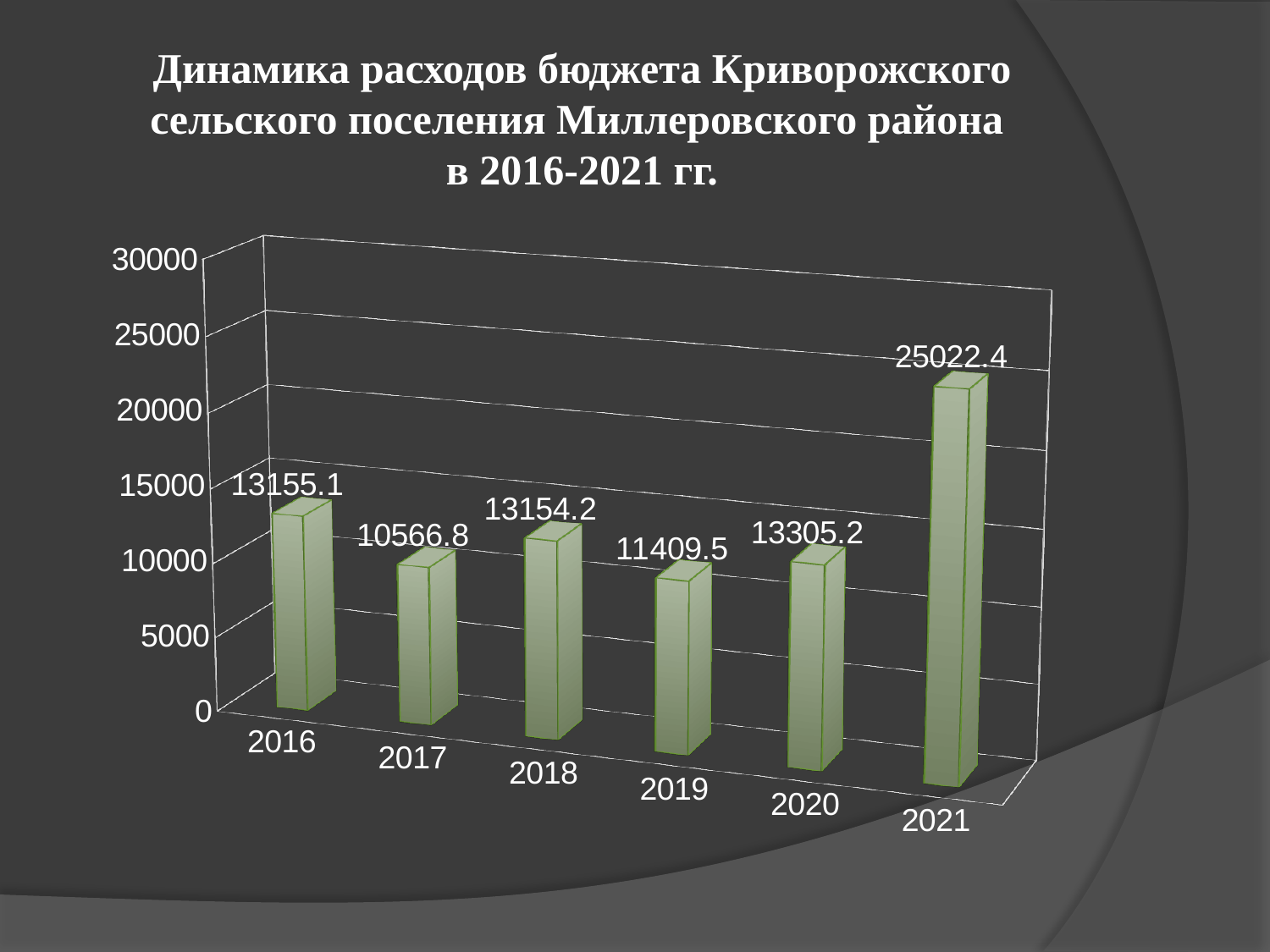
Which year has the lowest value? 2017 What is the difference between the values for 2021 and 2016? 11867.3 What is the value for 2019? 11409.5 What is the value for 2021? 25022.4 Which is larger, the value for 2018 or the value for 2019? 2018 What is the value for 2017? 10566.8 What is the difference between the values for 2020 and 2019? 1895.7 Which year has the highest value? 2021 How many years are shown on the x axis? 6 What kind of chart is shown on the slide? bar chart What is the value for 2020? 13305.2 Is the value for 2021 greater or less than 20000? greater